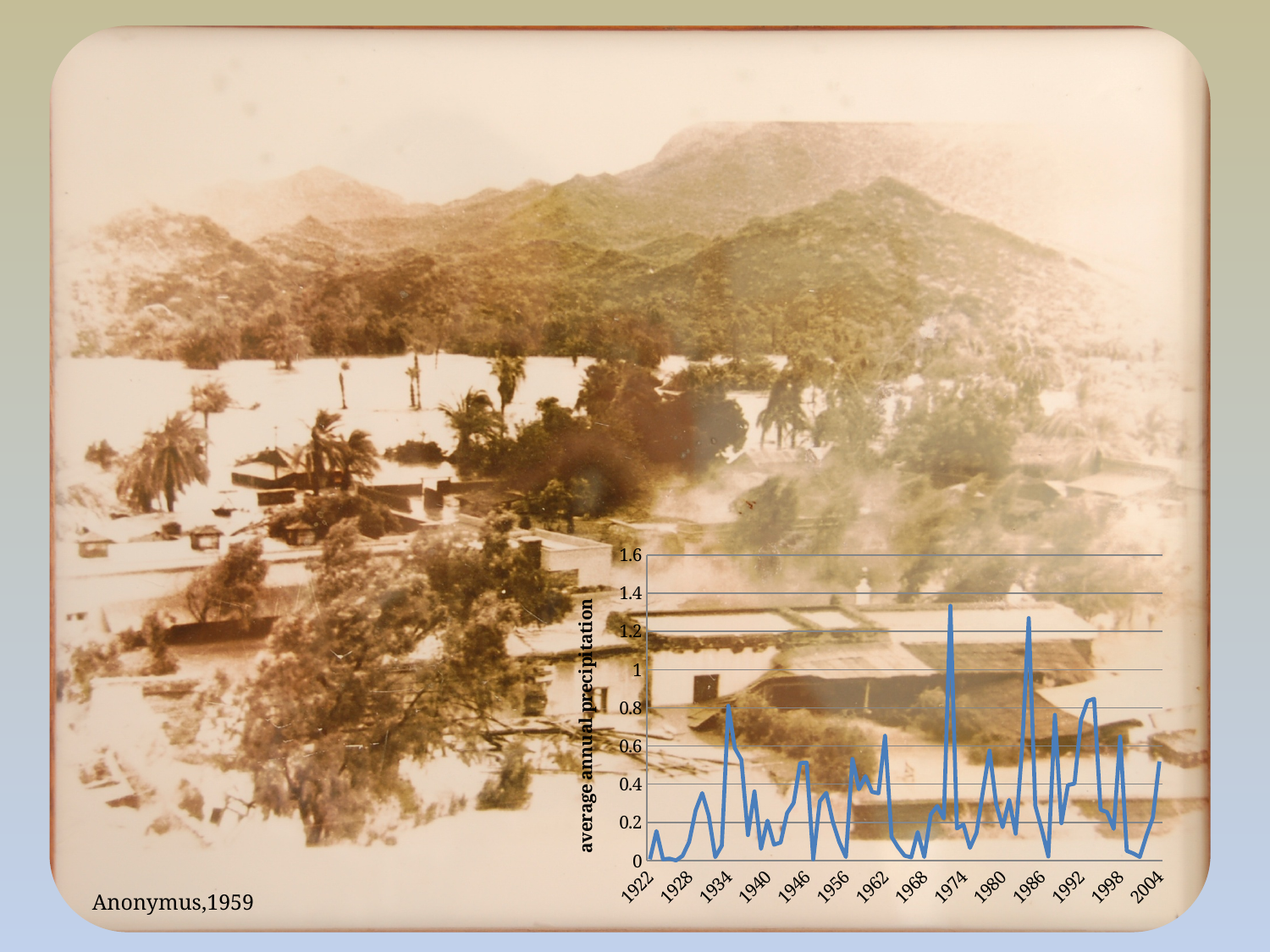
Is the highest peak of the line greater or less than 1.2? greater What is the last year label on the horizontal axis of the chart? 2004 What is the label on the vertical axis of the chart? average annual precipitation Is the value at 1922 greater or less than 0.2? less What is the highest value shown on the vertical axis of the chart? 1.6 What is the first year label on the horizontal axis of the chart? 1922 Is the value at 2004 greater or less than 0.4? greater How many data series are plotted in the chart? 1 How many year labels are printed on the horizontal axis of the chart? 14 What kind of chart is shown on the slide? line chart Is the highest peak in the 1930s larger or smaller than the highest peak in the 1970s? smaller